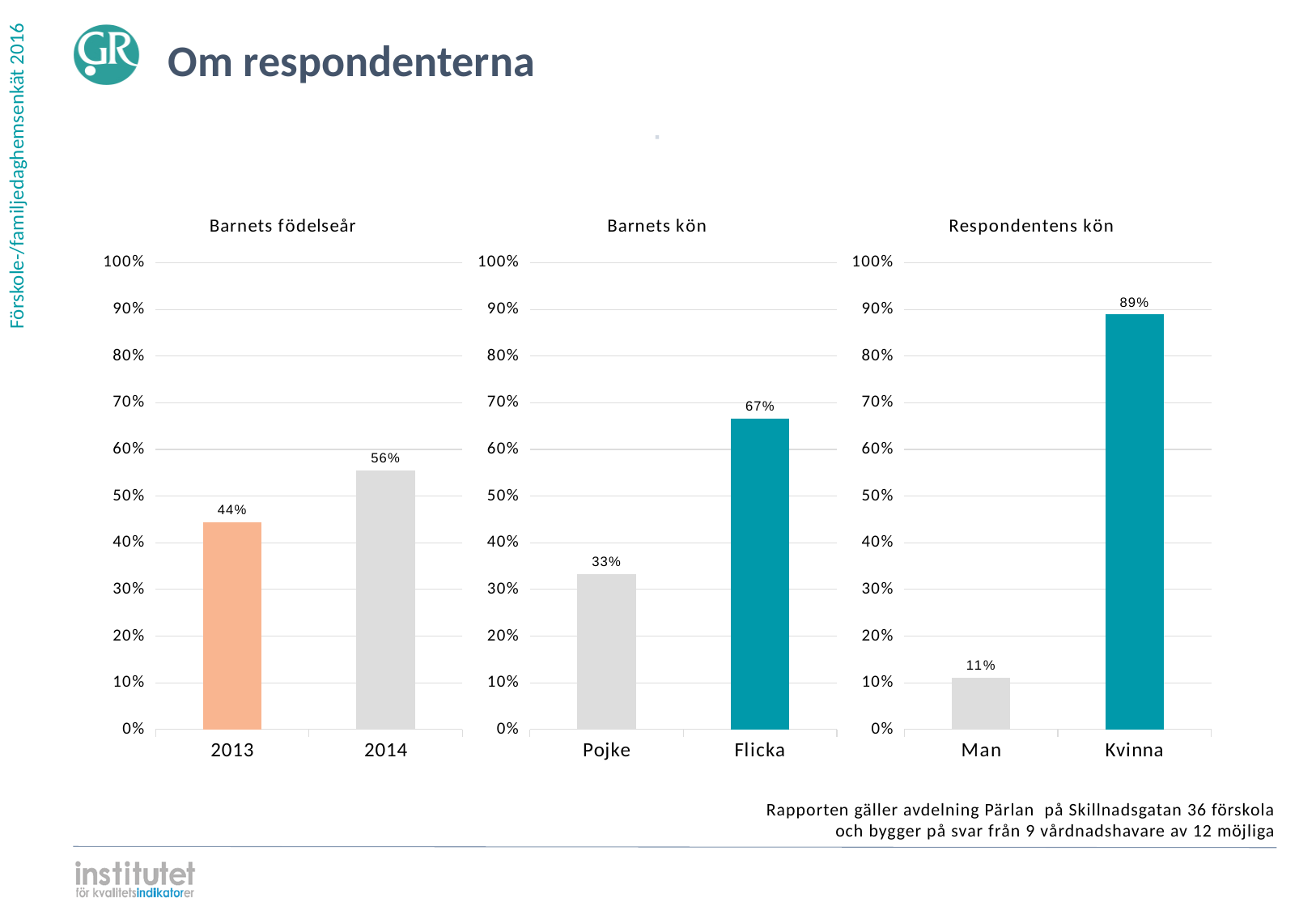
In the 'Barnets kön' chart, what is the value for Pojke? 33% In the 'Barnets födelseår' chart, what is the value for 2013? 44% In the 'Barnets kön' chart, what is the value for Flicka? 67% In the 'Barnets födelseår' chart, which is larger, 2013 or 2014? 2014 In the 'Respondentens kön' chart, what is the value for Kvinna? 89% In the 'Barnets kön' chart, is the value for Pojke greater or less than 40%? less What kind of chart is the 'Respondentens kön' chart? bar chart How many categories does the 'Barnets födelseår' chart show? 2 In the 'Barnets födelseår' chart, what is the value for 2014? 56% In the 'Respondentens kön' chart, what is the difference between Kvinna and Man? 78% In the 'Barnets kön' chart, which category has the highest value? Flicka In the 'Respondentens kön' chart, which category has the lowest value? Man